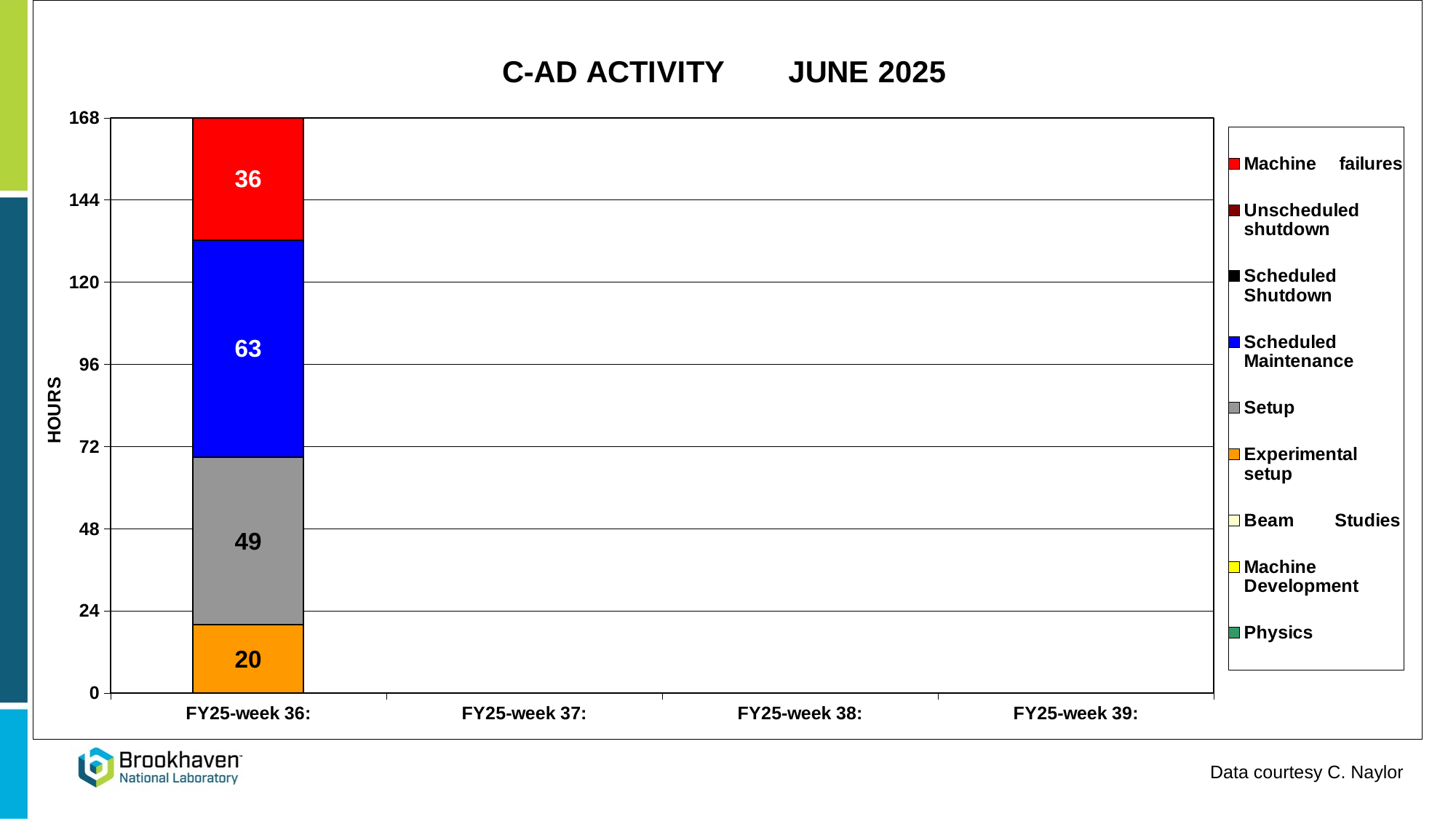
Which series has the smallest labelled value in the FY25-week 36 bar? Experimental setup Which series has the largest value in the FY25-week 36 bar? Scheduled Maintenance What is the title of the chart? C-AD ACTIVITY JUNE 2025 What is the value for Machine failures in FY25-week 36? 36 How many categories are shown on the x axis? 4 What kind of chart is shown on the slide? Stacked bar chart What is the difference between the Scheduled Maintenance and Setup values in FY25-week 36? 14 What is the value for Setup in FY25-week 36? 49 How many series does the legend list? 9 What is the total of the FY25-week 36 stacked bar? 168 What is the value for Scheduled Maintenance in FY25-week 36? 63 What is the value for Experimental setup in FY25-week 36? 20